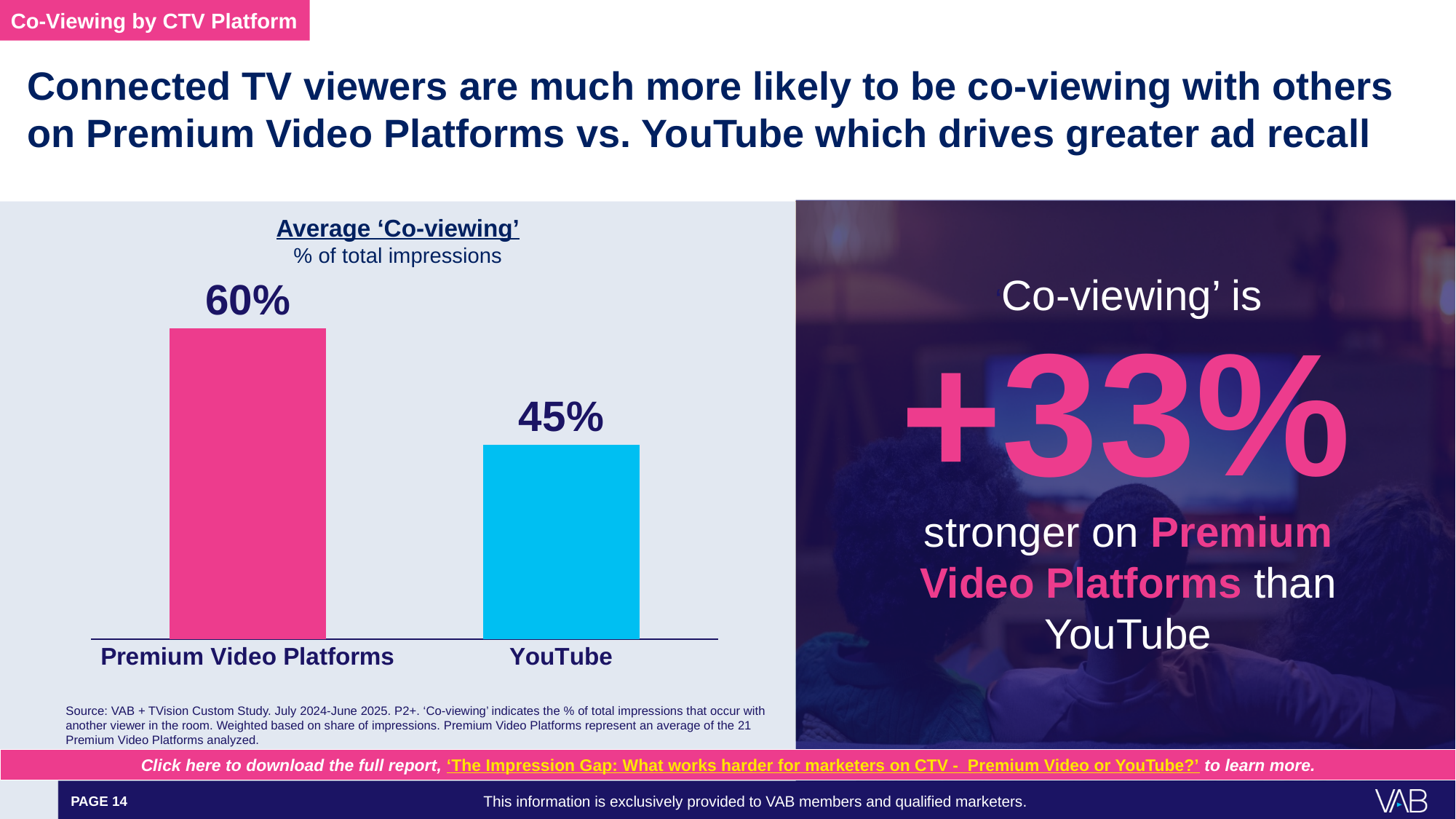
Which category has the highest average co-viewing percentage? Premium Video Platforms What is the difference in average co-viewing between Premium Video Platforms and YouTube? 15% Which has a larger average co-viewing share, Premium Video Platforms or YouTube? Premium Video Platforms What is the average co-viewing value for YouTube? 45% What kind of chart is shown on the slide? Bar chart How many categories are shown in the chart? 2 What unit is the chart measured in, according to its subtitle? % of total impressions What is the title of the chart? Average 'Co-viewing' Which category has the lowest average co-viewing percentage? YouTube Do the values fall or rise from Premium Video Platforms to YouTube? Fall What is the average co-viewing value for Premium Video Platforms? 60%